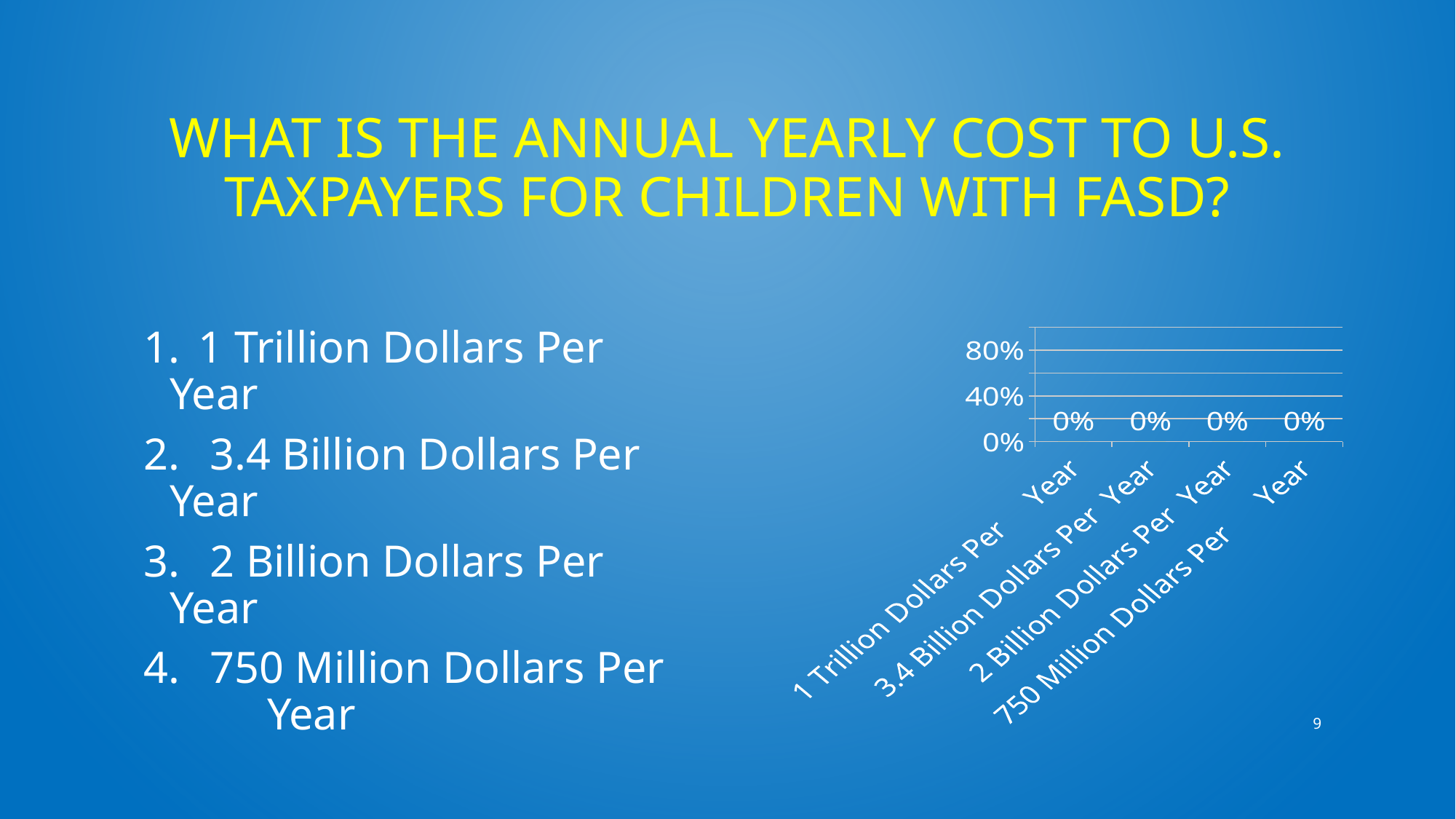
How many categories are shown on the chart's x axis? 4 What is the value shown for "1 Trillion Dollars Per Year"? 0% What is the value shown for "3.4 Billion Dollars Per Year"? 0% Is the value for "1 Trillion Dollars Per Year" greater or less than 80%? less What is the lowest tick label shown on the chart's vertical axis? 0% What is the difference between the values for "3.4 Billion Dollars Per Year" and "750 Million Dollars Per Year"? 0% What is the value shown for "750 Million Dollars Per Year"? 0% Is the value for "2 Billion Dollars Per Year" greater or less than 40%? less What is the highest tick label shown on the chart's vertical axis? 80% What is the value shown for "2 Billion Dollars Per Year"? 0%